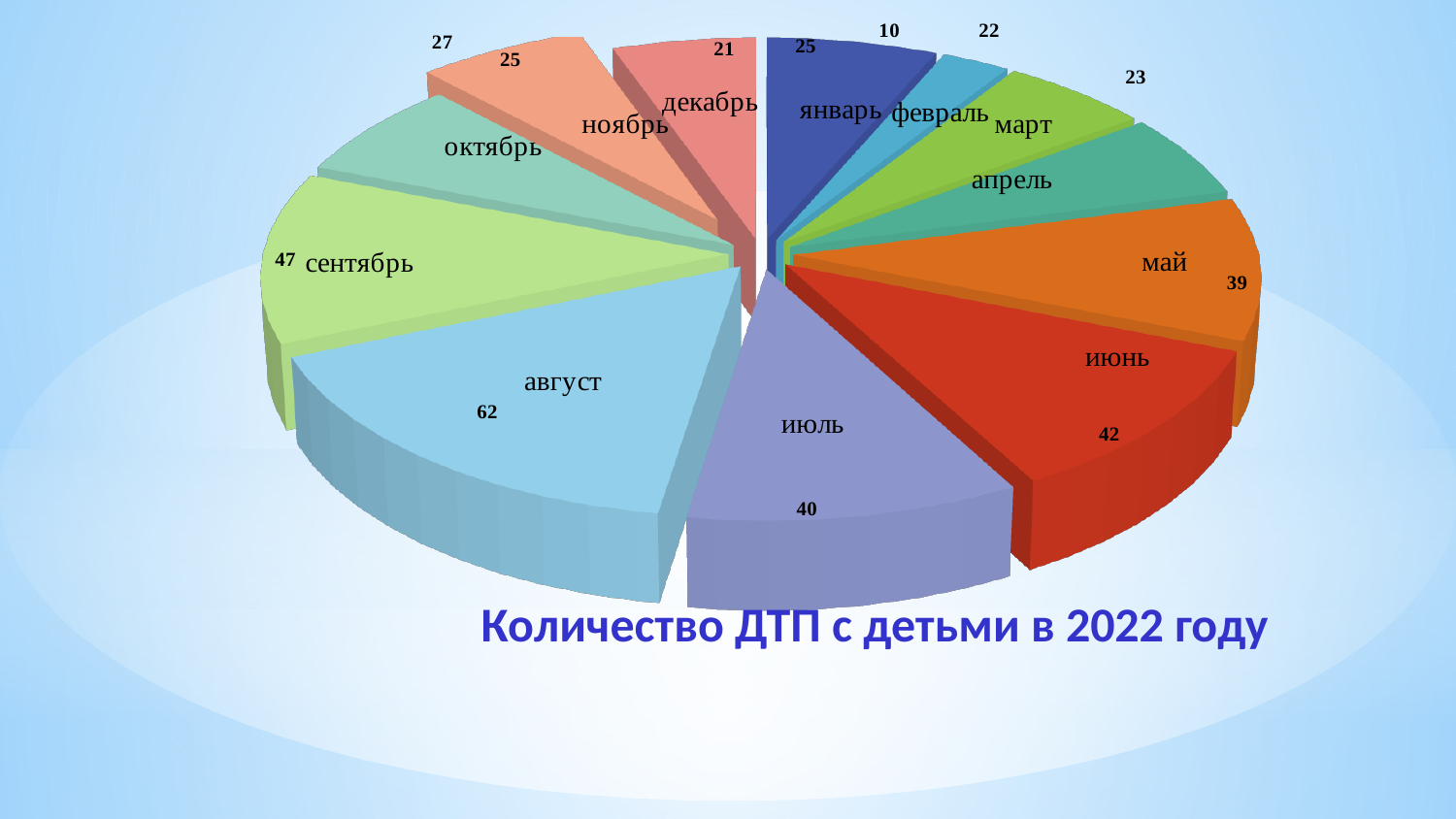
What kind of chart is shown on the slide? Pie chart Which is larger, the value for июнь or the value for июль? июнь What is the difference between the values for июнь and май? 3 What is the title of the chart? Количество ДТП с детьми в 2022 году What is the difference between the values for август and сентябрь? 15 Which month has the largest slice? август Which month has the smallest slice? февраль What is the value for август? 62 What is the value for сентябрь? 47 What is the value for май? 39 What is the value for февраль? 10 How many slices (months) does the pie chart have? 12